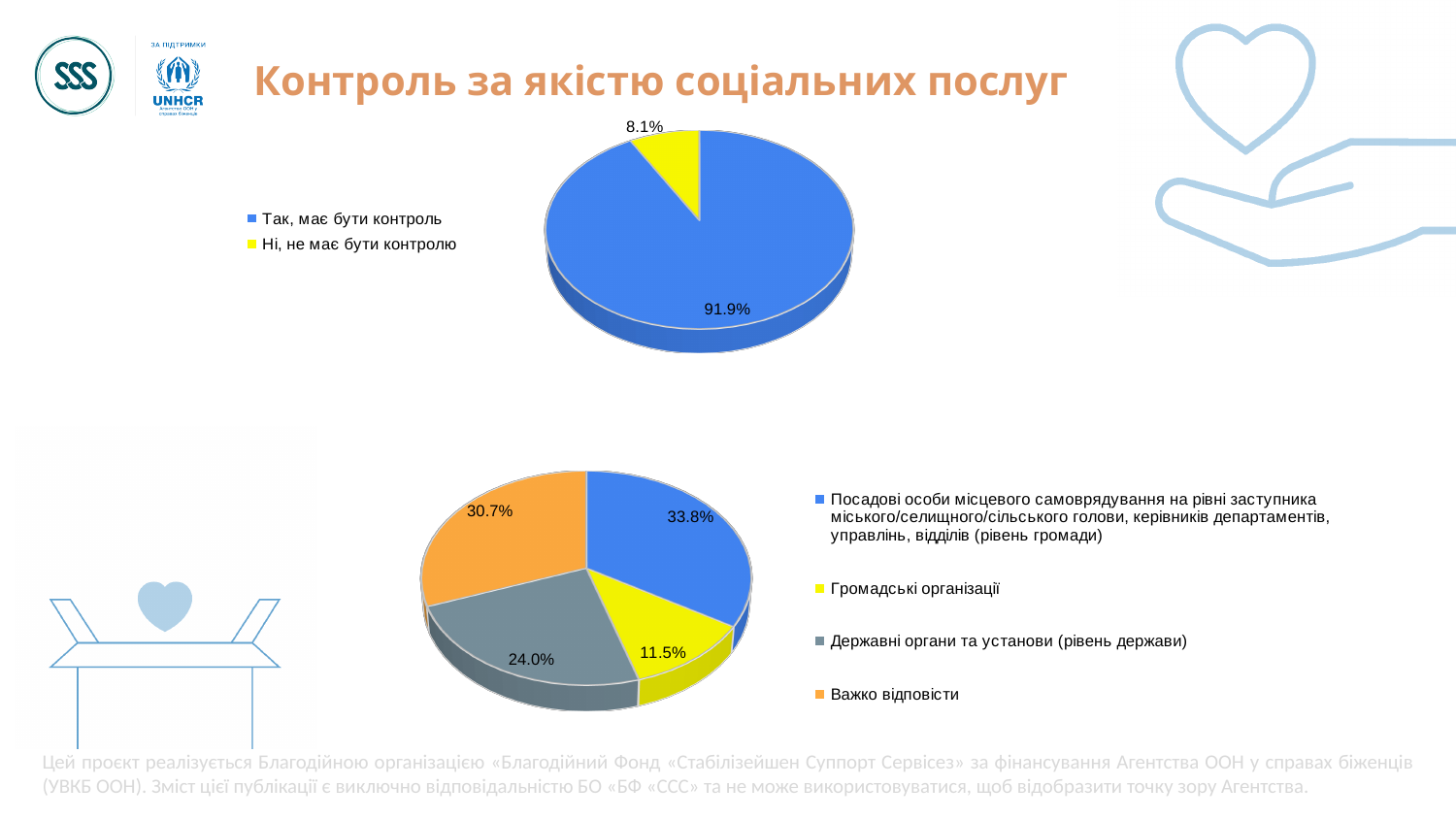
How many slices does the bottom pie chart have? 4 In the top pie chart, what is the difference between the "Так, має бути контроль" and "Ні, не має бути контролю" slices? 83.8% In the bottom pie chart, which slice is the smallest? Громадські організації In the top pie chart, which slice is the largest? Так, має бути контроль In the bottom pie chart, what share is shown for "Державні органи та установи (рівень держави)"? 24.0% In the bottom pie chart, what share is shown for "Громадські організації"? 11.5% What kind of chart is the bottom chart on the slide? Pie chart In the top pie chart, what share is shown for "Так, має бути контроль"? 91.9% In the bottom pie chart, which is larger: "Важко відповісти" or "Державні органи та установи (рівень держави)"? Важко відповісти How many entries does the legend of the top pie chart list? 2 In the bottom pie chart, what share is shown for "Важко відповісти"? 30.7% In the top pie chart, what share is shown for "Ні, не має бути контролю"? 8.1%